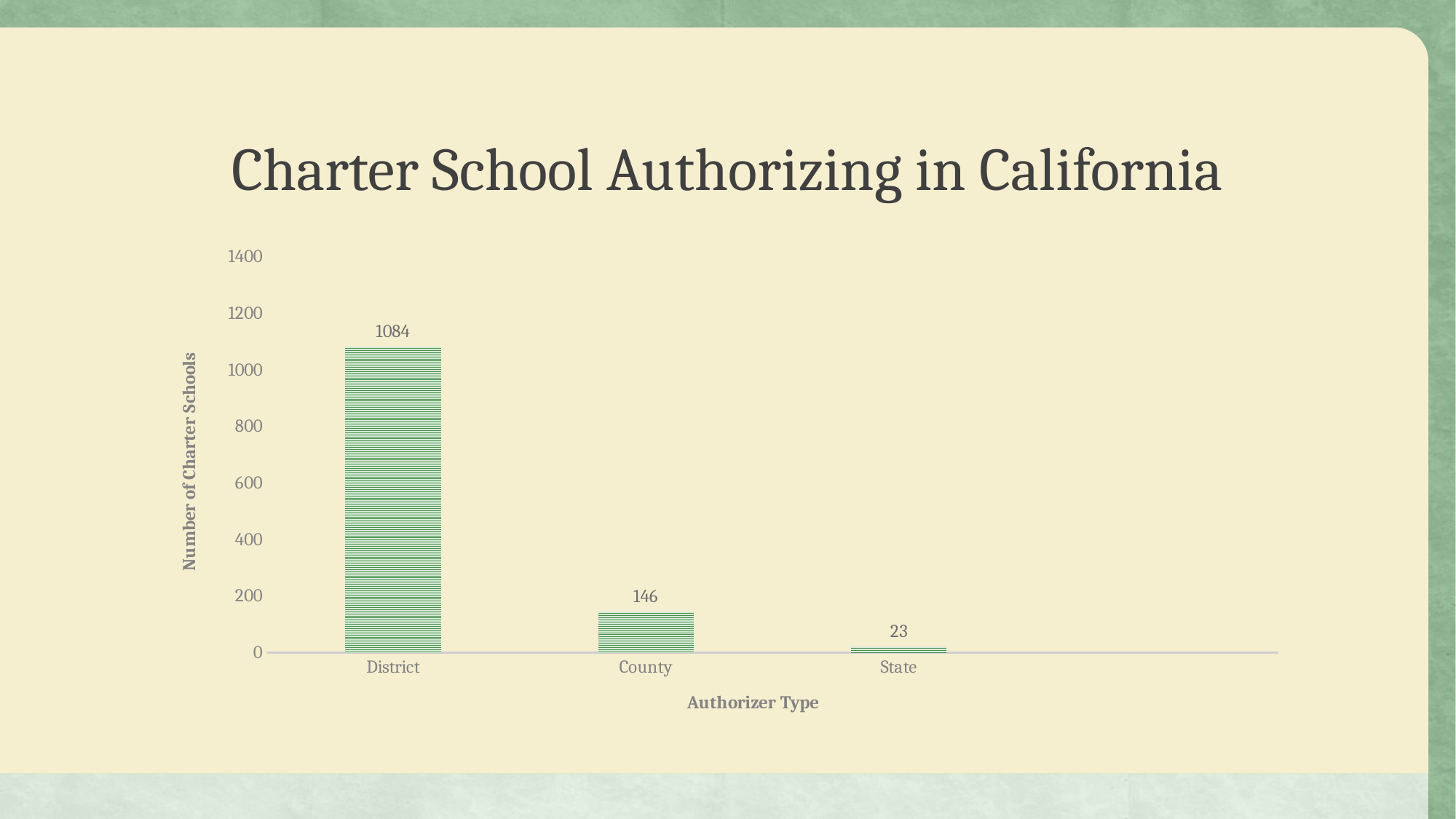
Is the value for District greater or less than 1000? greater How many charter schools are authorized by County authorizers? 146 Which authorizer type has the lowest number of charter schools? State What is the difference between the number of charter schools authorized by District and County authorizers? 938 What is the difference between the County and State values? 123 Which has more charter schools, County or State authorizers? County How many charter schools are authorized by the State? 23 What kind of chart is shown on the slide? Bar chart What is the label of the vertical axis? Number of Charter Schools How many authorizer types are shown on the x axis? 3 Which authorizer type has the highest number of charter schools? District How many charter schools are authorized by District authorizers? 1084